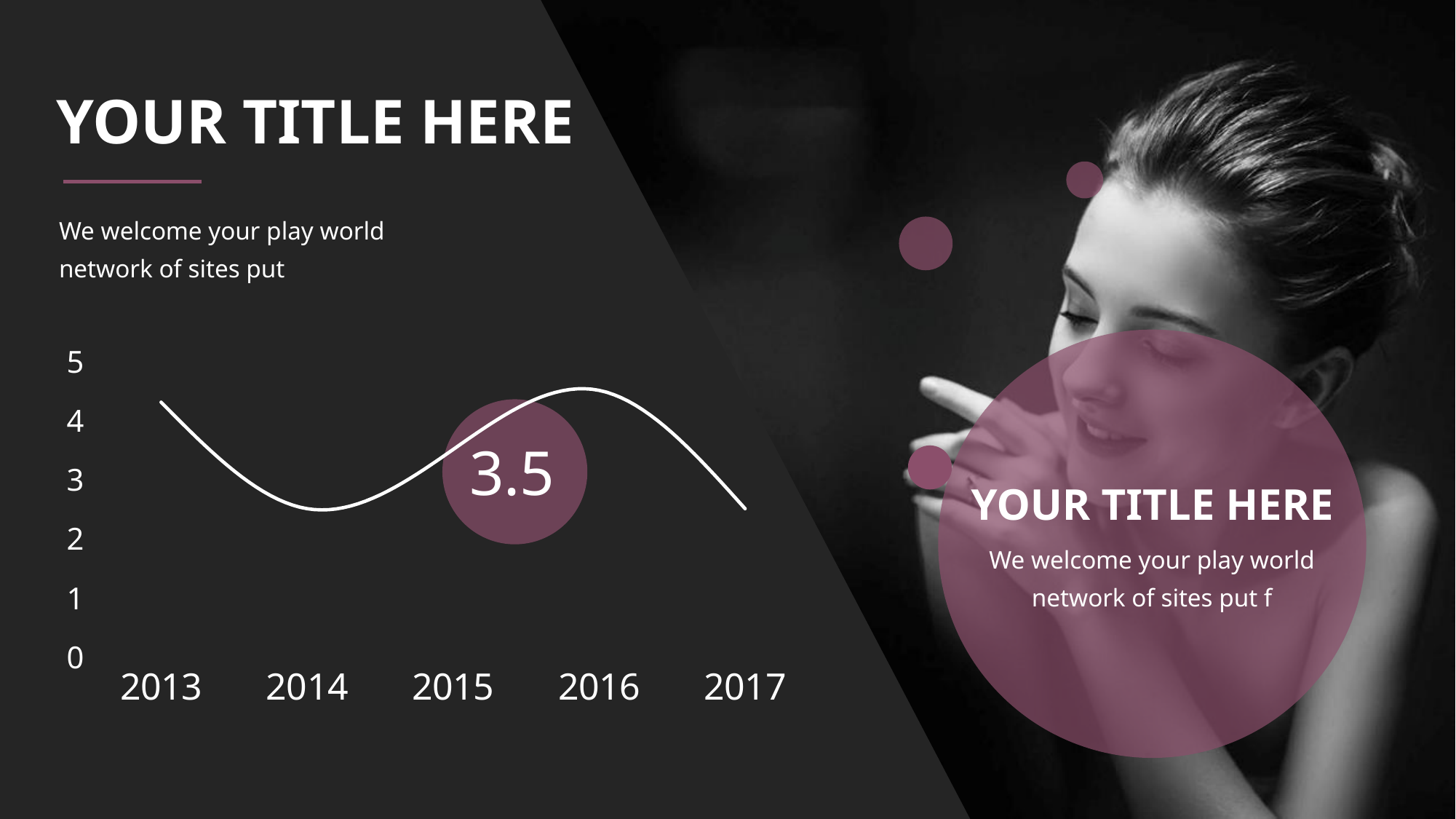
Is the value for 2014 greater or less than 3? less Does the line rise or fall from 2014 to 2016? rises Which has the larger value, 2016 or 2017? 2016 What kind of chart is shown on the slide? line chart Is the value for 2013 greater or less than 4? greater Is the value for 2017 greater or less than 3? less What number is printed inside the circle overlaid on the chart? 3.5 Which has the larger value, 2014 or 2015? 2015 What is the highest tick value shown on the y axis of the chart? 5 How many years are shown on the x axis of the chart? 5 Which has the larger value, 2013 or 2014? 2013